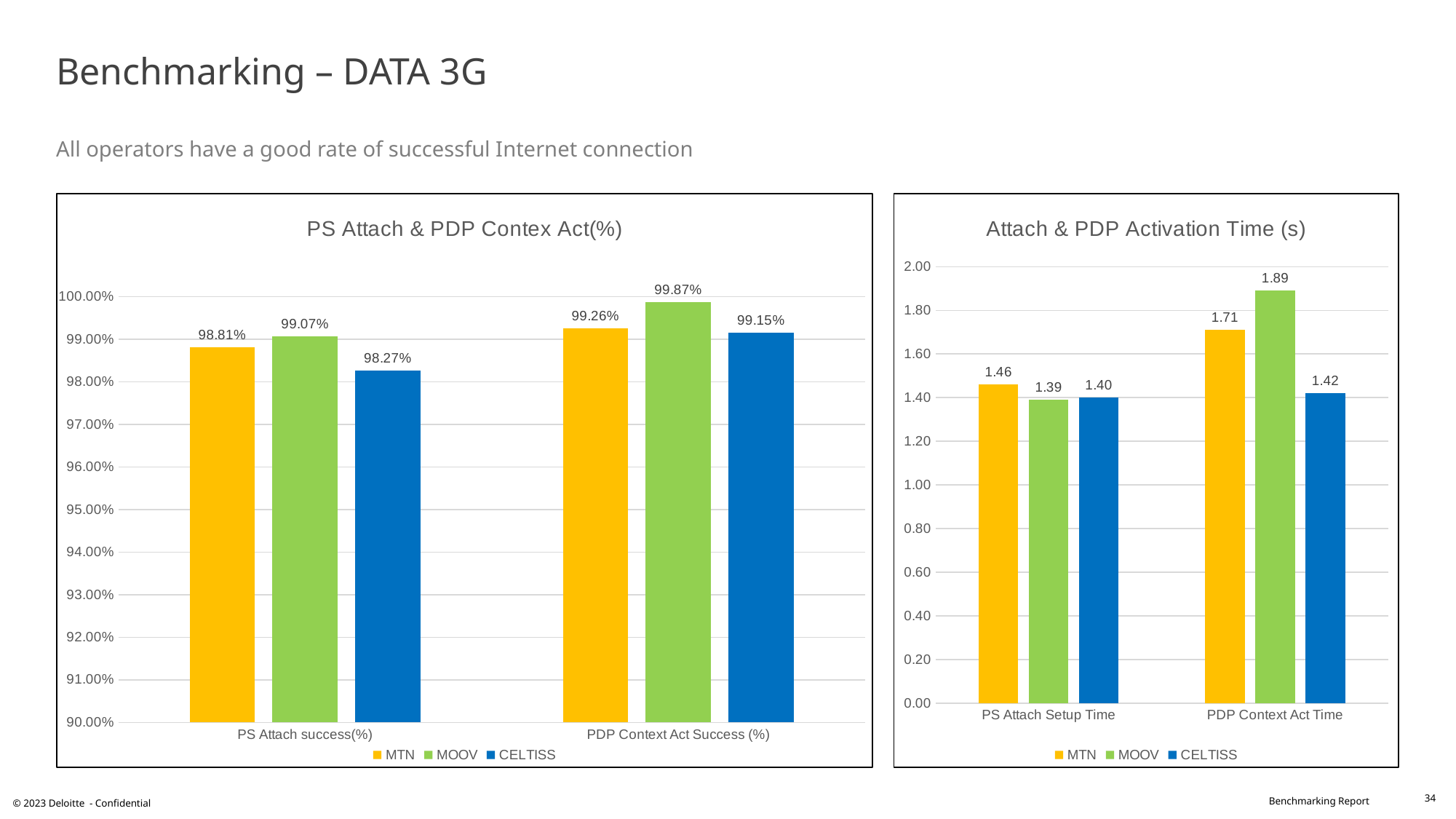
In the 'Attach & PDP Activation Time (s)' chart, which operator has the highest PDP Context Act Time? MOOV In the 'Attach & PDP Activation Time (s)' chart, is the PS Attach Setup Time for MTN greater or less than the PDP Context Act Time for MTN? less In the 'PS Attach & PDP Contex Act(%)' chart, what is the difference between MOOV's and MTN's PDP Context Act Success (%)? 0.61% What kind of chart is the 'PS Attach & PDP Contex Act(%)' chart? bar chart In the 'Attach & PDP Activation Time (s)' chart, what is the PDP Context Act Time for MTN? 1.71 In the 'PS Attach & PDP Contex Act(%)' chart, what is the value for MOOV in PS Attach success(%)? 99.07% In the 'PS Attach & PDP Contex Act(%)' chart, which operator has the highest PDP Context Act Success (%)? MOOV In the 'Attach & PDP Activation Time (s)' chart, what is the PS Attach Setup Time for MOOV? 1.39 In the 'PS Attach & PDP Contex Act(%)' chart, what is the value for CELTISS in PDP Context Act Success (%)? 99.15% How many series does the legend of the 'Attach & PDP Activation Time (s)' chart list? 3 In the 'PS Attach & PDP Contex Act(%)' chart, which operator has the lowest PS Attach success(%)? CELTISS In the 'Attach & PDP Activation Time (s)' chart, what is the difference between MOOV's PDP Context Act Time and CELTISS's PDP Context Act Time? 0.47